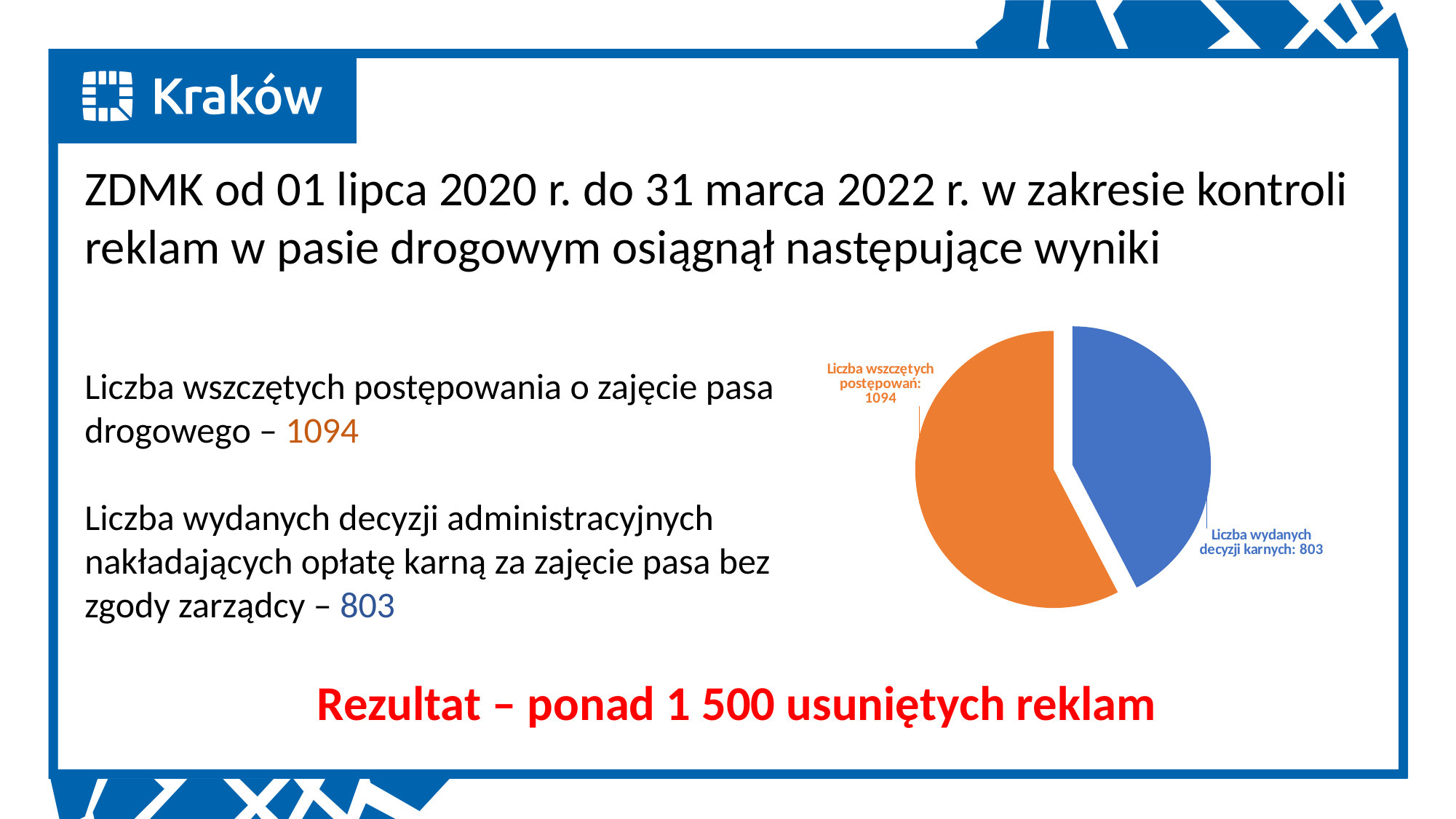
What colour is the "Liczba wydanych decyzji karnych" slice in the pie chart? blue Which is larger in the pie chart: "Liczba wszczętych postępowań" or "Liczba wydanych decyzji karnych"? Liczba wszczętych postępowań Which slice of the pie chart is the smallest? Liczba wydanych decyzji karnych What colour is the "Liczba wszczętych postępowań" slice in the pie chart? orange What is the difference between the value for "Liczba wszczętych postępowań" and the value for "Liczba wydanych decyzji karnych"? 291 What value is shown for "Liczba wydanych decyzji karnych" in the pie chart? 803 Which slice of the pie chart is the largest? Liczba wszczętych postępowań How many slices does the pie chart have? 2 What kind of chart is shown on the slide? pie chart What is the total of the two values shown in the pie chart? 1897 What value is shown for "Liczba wszczętych postępowań" in the pie chart? 1094